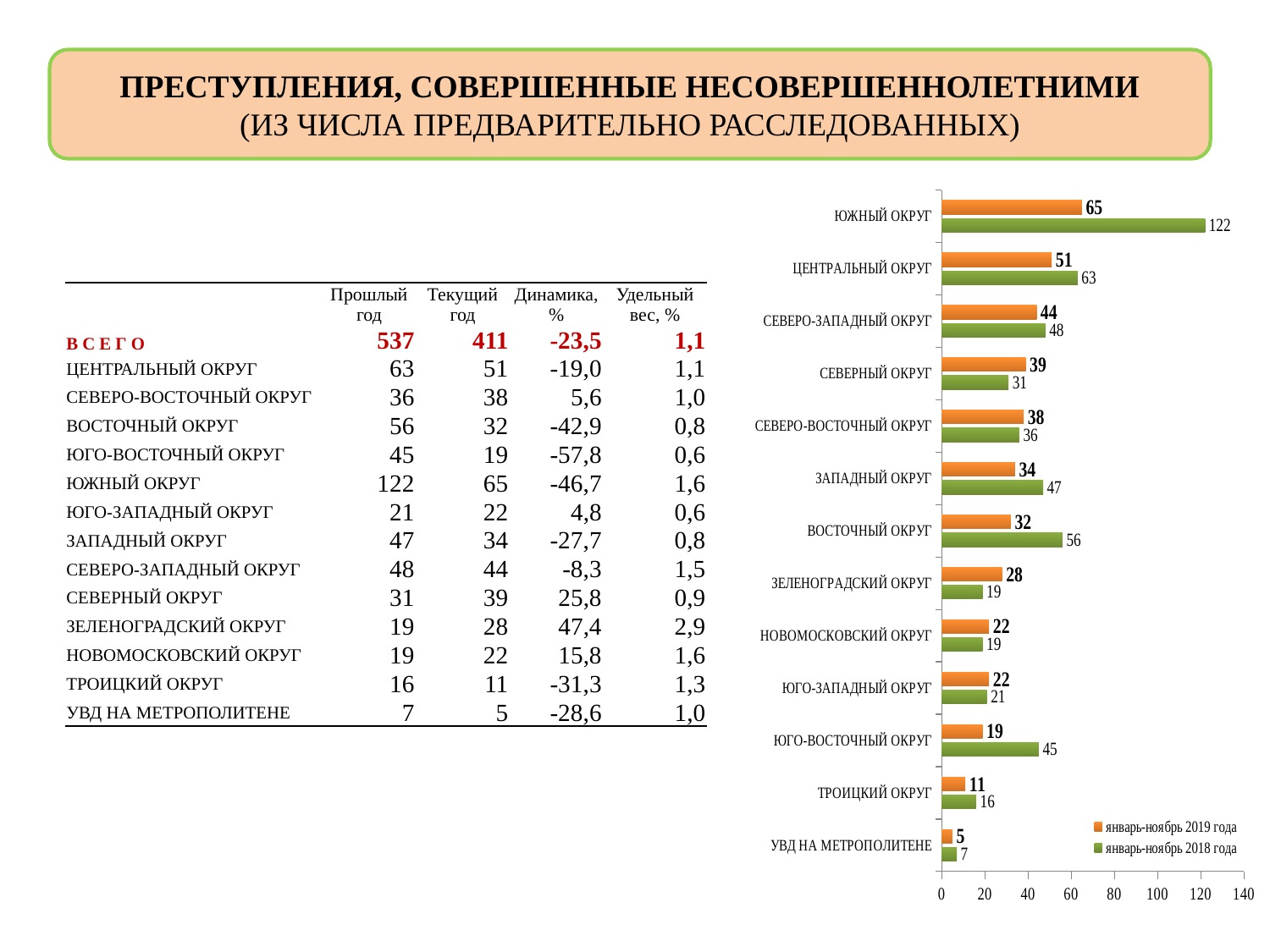
What kind of chart is shown on the slide? bar chart Which district has the highest value in the январь-ноябрь 2018 года series? ЮЖНЫЙ ОКРУГ What is the value for ЮЖНЫЙ ОКРУГ in the январь-ноябрь 2019 года series? 65 Which is larger for СЕВЕРНЫЙ ОКРУГ: the январь-ноябрь 2019 года value or the январь-ноябрь 2018 года value? январь-ноябрь 2019 года What is the value for ЗЕЛЕНОГРАДСКИЙ ОКРУГ in the январь-ноябрь 2019 года series? 28 How many categories (districts) are plotted on the chart? 13 Is the value for ЮЖНЫЙ ОКРУГ in the январь-ноябрь 2018 года series greater or less than 100? greater How many series does the chart legend list? 2 What is the difference between the 2018 and 2019 values for ЮГО-ВОСТОЧНЫЙ ОКРУГ? 26 Which category has the lowest value in the январь-ноябрь 2019 года series? УВД НА МЕТРОПОЛИТЕНЕ Which colour represents the январь-ноябрь 2018 года series on the chart? green What is the value for ВОСТОЧНЫЙ ОКРУГ in the январь-ноябрь 2018 года series? 56